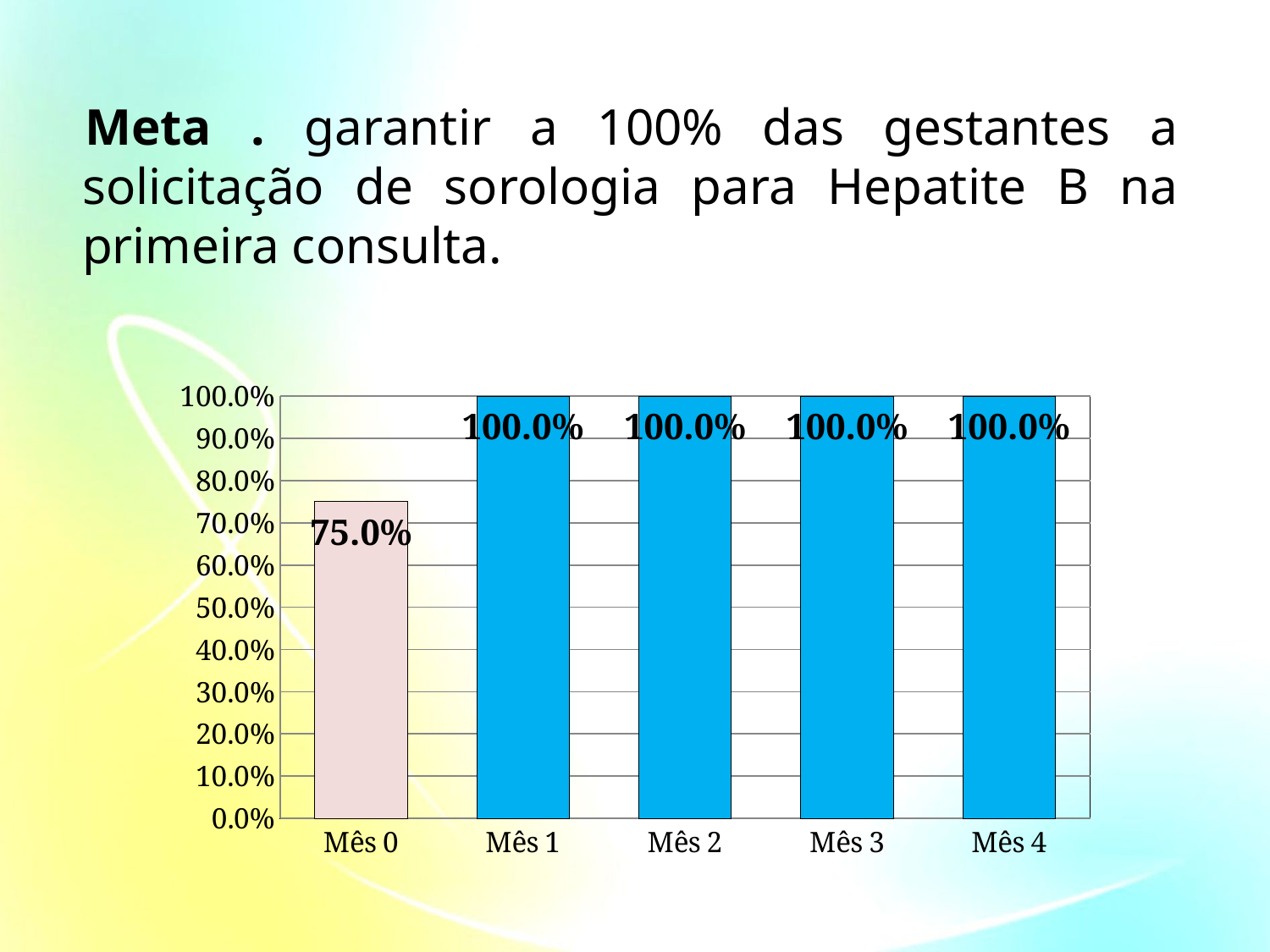
What is the value for Mês 4? 100.0% What kind of chart is shown on the slide? bar chart What is the value for Mês 0? 75.0% How many categories are shown on the x axis? 5 How many categories have a value of 100.0%? 4 Which category has the lowest value? Mês 0 Do the values rise or fall from Mês 0 to Mês 1? rise Is the value for Mês 0 greater or less than 80.0%? less What is the difference between the values for Mês 1 and Mês 0? 25.0% Which bar is shown in a different colour from the others? Mês 0 Which is larger, the value for Mês 0 or the value for Mês 3? Mês 3 What is the value for Mês 2? 100.0%